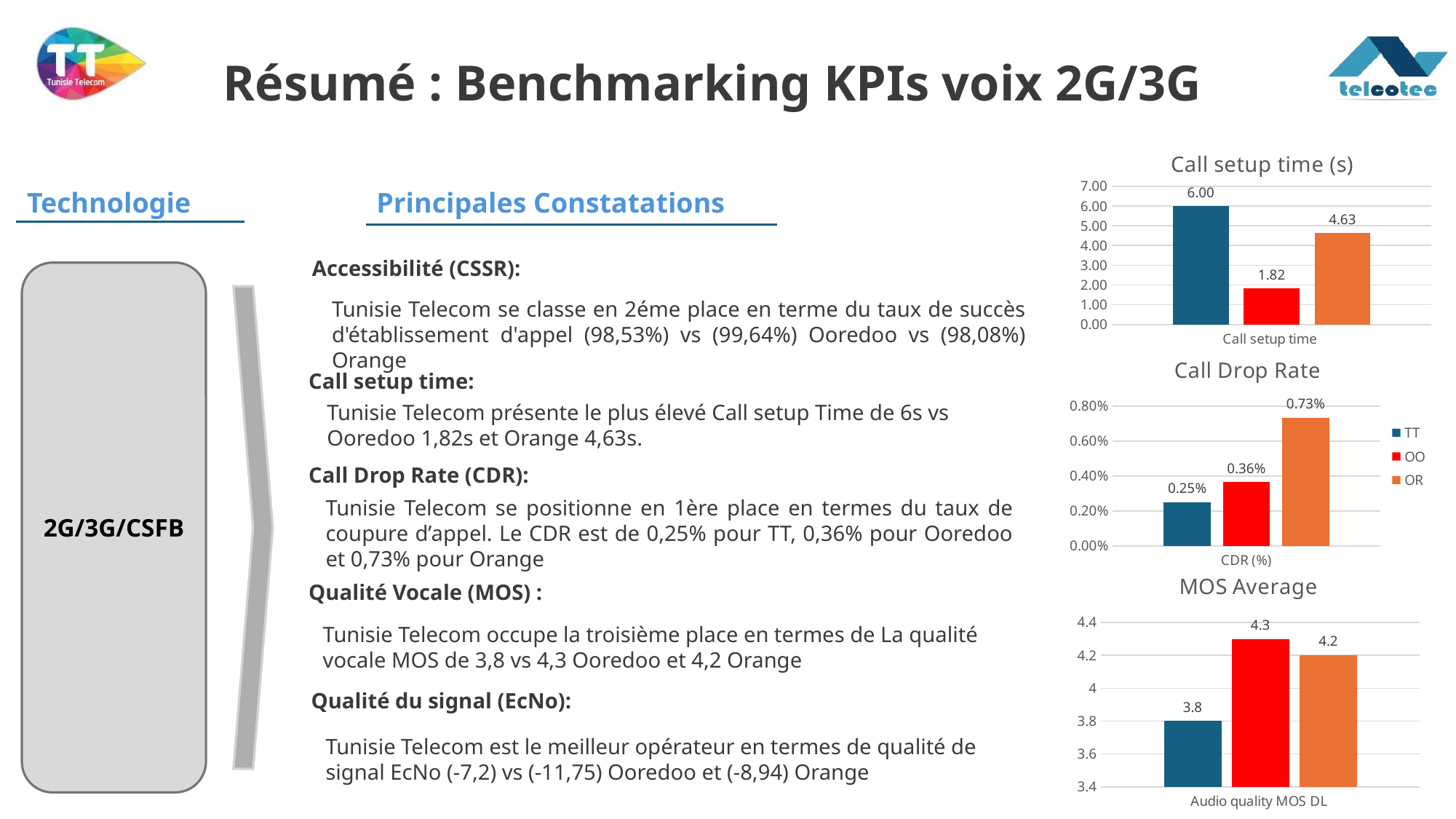
In the Call setup time (s) chart, what is the value of the blue bar (TT)? 6.00 In the Call Drop Rate chart, is the value for OO greater or less than 0.40%? less In the Call setup time (s) chart, which bar is the lowest? OO (red bar) In the MOS Average chart, what is the difference between the OO bar and the TT bar? 0.5 How many series does the legend of the Call Drop Rate chart list? 3 In the Call setup time (s) chart, what is the difference between the TT bar and the OR bar? 1.37 In the Call Drop Rate chart, which series has the lowest value? TT In the Call setup time (s) chart, what is the value of the red bar (OO)? 1.82 In the MOS Average chart, which bar is the highest? OO (red bar) In the MOS Average chart, what is the value of the red bar (OO)? 4.3 In the Call Drop Rate chart, what is the value for OR? 0.73% What type of chart is the MOS Average chart? Bar chart